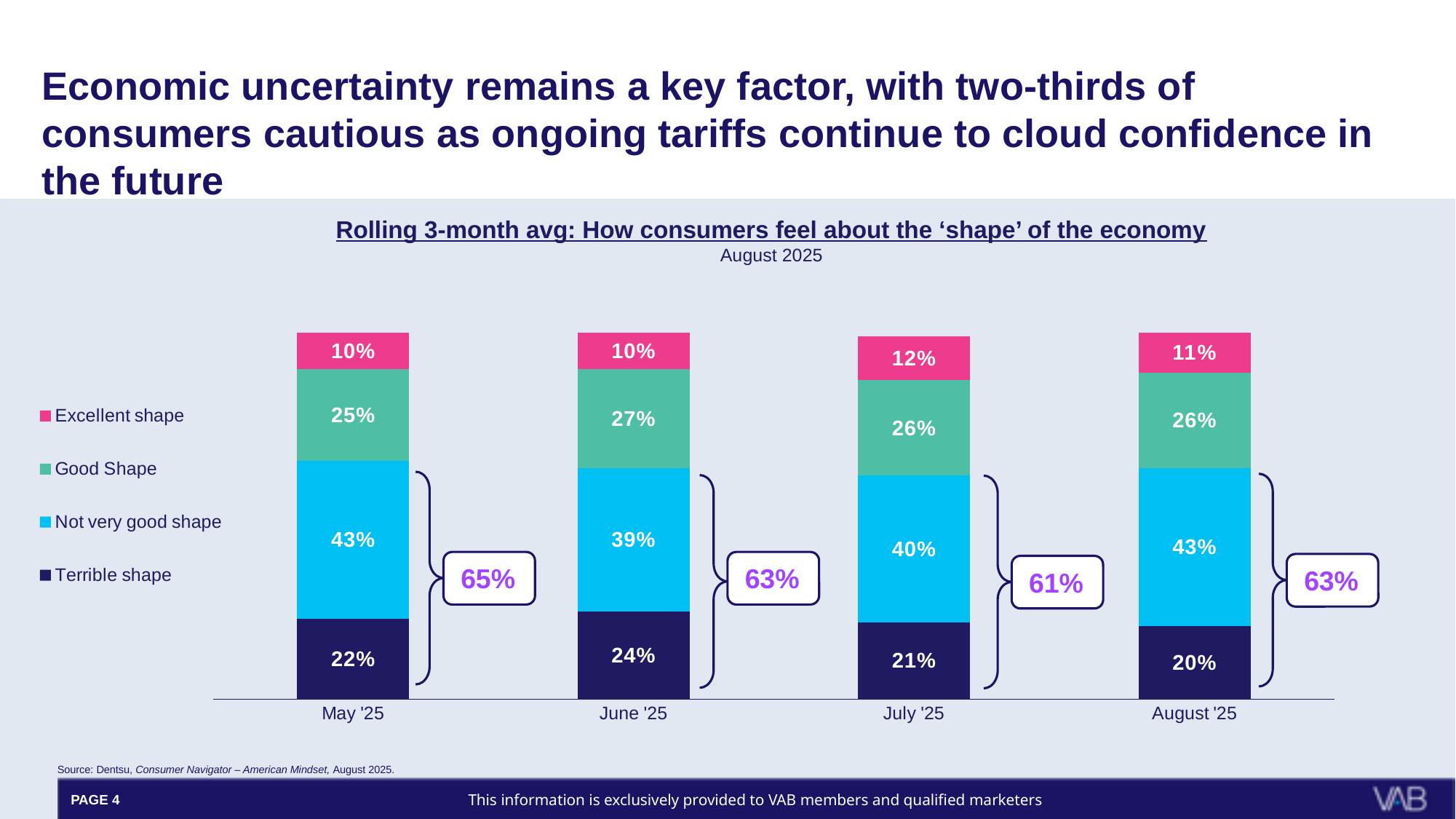
How many series does the legend list? 4 Which month has the lowest 'Terrible shape' value? August '25 What is the 'Excellent shape' value for July '25? 12% How many months are shown on the x axis? 4 What is the combined share of 'Not very good shape' and 'Terrible shape' for July '25, as shown in the callout? 61% What is the 'Not very good shape' value for August '25? 43% Is the 'Good Shape' value larger in June '25 or July '25? June '25 What percentage of consumers said the economy was in 'Terrible shape' in June '25? 24% Which month has the highest 'Excellent shape' value? July '25 What is the 'Good Shape' value for May '25? 25% What kind of chart is shown on the slide? Stacked bar chart What is the difference between the 'Not very good shape' values for May '25 and June '25? 4%